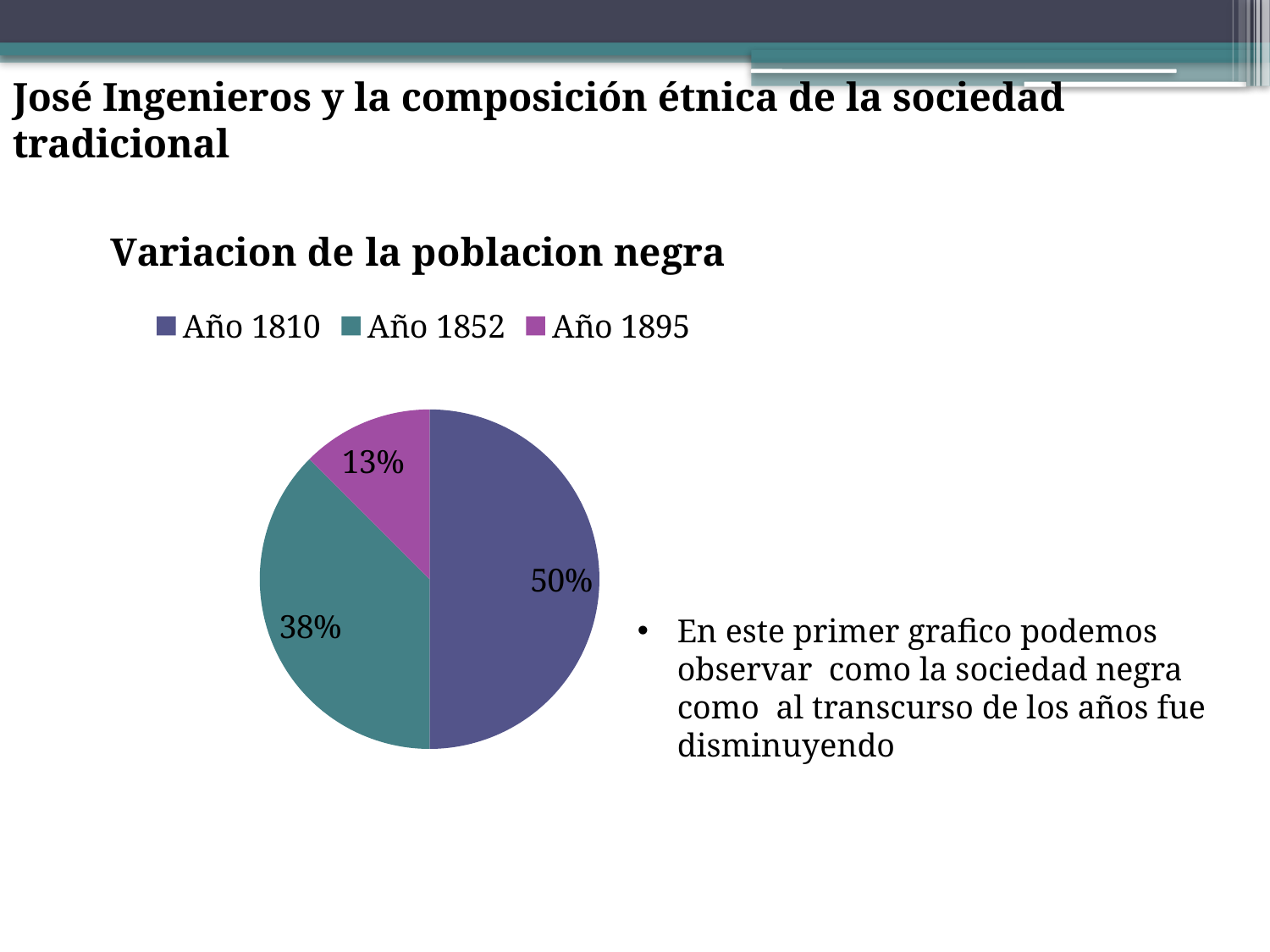
Which slice is the smallest in the pie chart? Año 1895 What type of chart is shown on the slide? pie chart What is the title of the chart? Variacion de la poblacion negra Which slice is the largest in the pie chart? Año 1810 What is the difference in percentage points between Año 1810 and Año 1895? 37 What share of the pie does Año 1810 represent? 50% Which legend entry is shown in purple/magenta? Año 1895 Which is larger, the share for Año 1852 or the share for Año 1895? Año 1852 How many slices does the pie chart have? 3 What share of the pie does Año 1852 represent? 38% How many entries does the legend list? 3 What share of the pie does Año 1895 represent? 13%